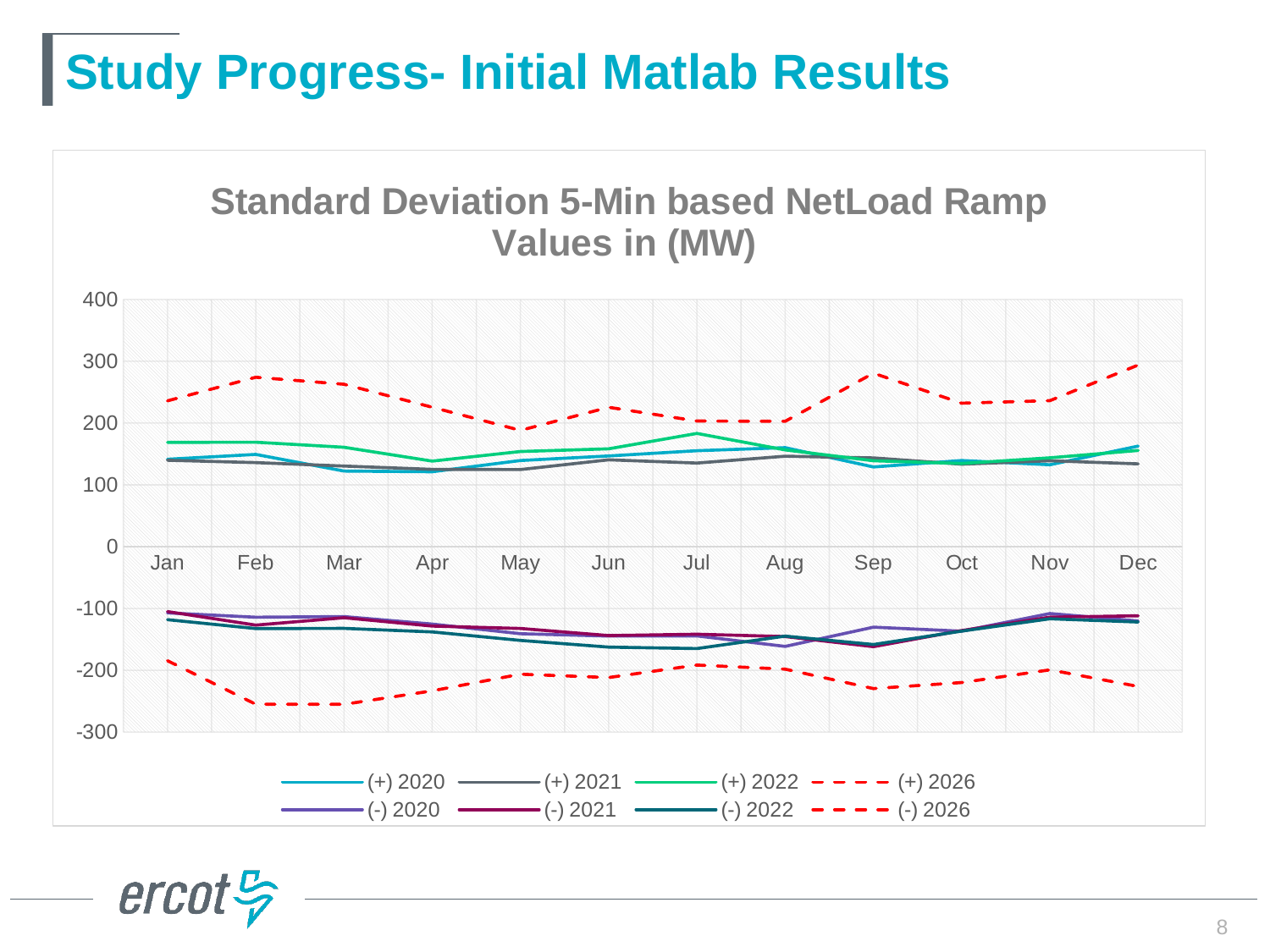
Is the value for (-) 2026 in Feb greater or less than -200? less Is the value for (+) 2022 in Jul greater or less than 100? greater What kind of chart is shown on the slide? line chart Which series has the highest values across the year? (+) 2026 Is the value for (+) 2026 in Sep greater or less than 200? greater In Jan, which is larger: the value for (+) 2026 or the value for (+) 2021? (+) 2026 How many months are plotted along the x axis? 12 Which series are drawn with dashed red lines? (+) 2026 and (-) 2026 What is the title of the chart? Standard Deviation 5-Min based NetLoad Ramp Values in (MW) How many series does the legend list? 8 In which month is the (+) 2026 series at its lowest value? May